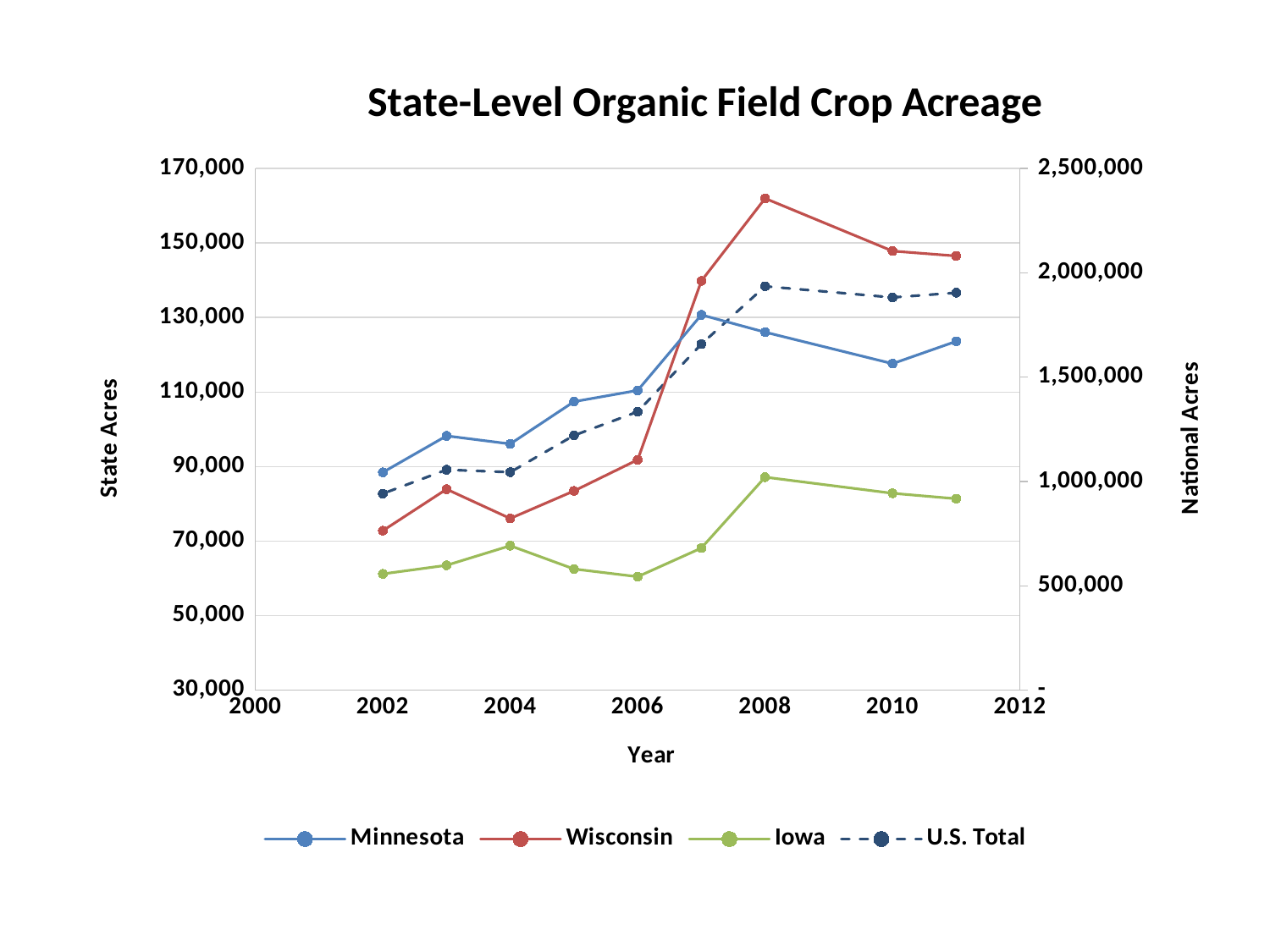
Does the Wisconsin series rise or fall from 2008 to 2011? Fall In which year does the Wisconsin series reach its highest value? 2008 How many series does the legend list? 4 How many data points are plotted for the Minnesota series? 9 In which year does the Minnesota series reach its highest value? 2007 In 2002, which has more organic field crop acreage, Minnesota or Wisconsin? Minnesota What kind of chart is shown on the slide? Line chart Is the value for Wisconsin in 2004 greater or less than 90,000 state acres? less In which year does the Iowa series reach its highest value? 2008 Is the value for Wisconsin in 2008 greater or less than 150,000 state acres? greater Is the value for Minnesota in 2010 greater or less than 110,000 state acres? greater Which series is drawn with a dashed line? U.S. Total